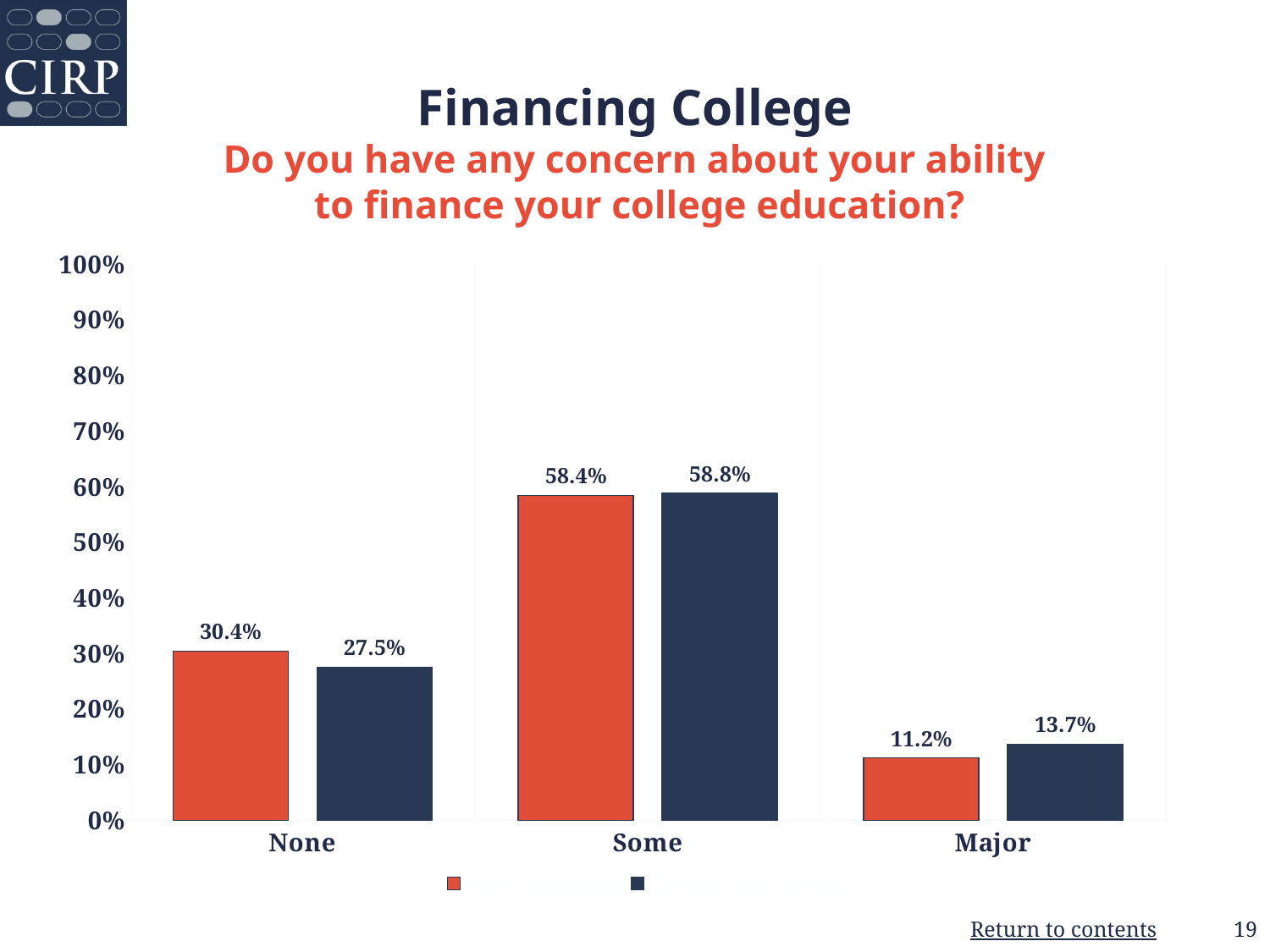
What is the difference between the dark blue and orange bars for the "Major" category? 2.5% How many series does the legend show? 2 For the "None" category, which bar is larger, the orange or the dark blue? orange What kind of chart is shown on the slide? bar chart Which category has the lowest value for the dark blue series? Major What is the value of the orange bar for the "Major" category? 11.2% What is the value of the dark blue bar for the "Major" category? 13.7% What is the value of the dark blue bar for the "Some" category? 58.8% What is the difference between the orange and dark blue bars for the "None" category? 2.9% What is the value of the orange bar for the "None" category? 30.4% Which category has the highest value for the orange series? Some How many categories are shown on the x axis? 3